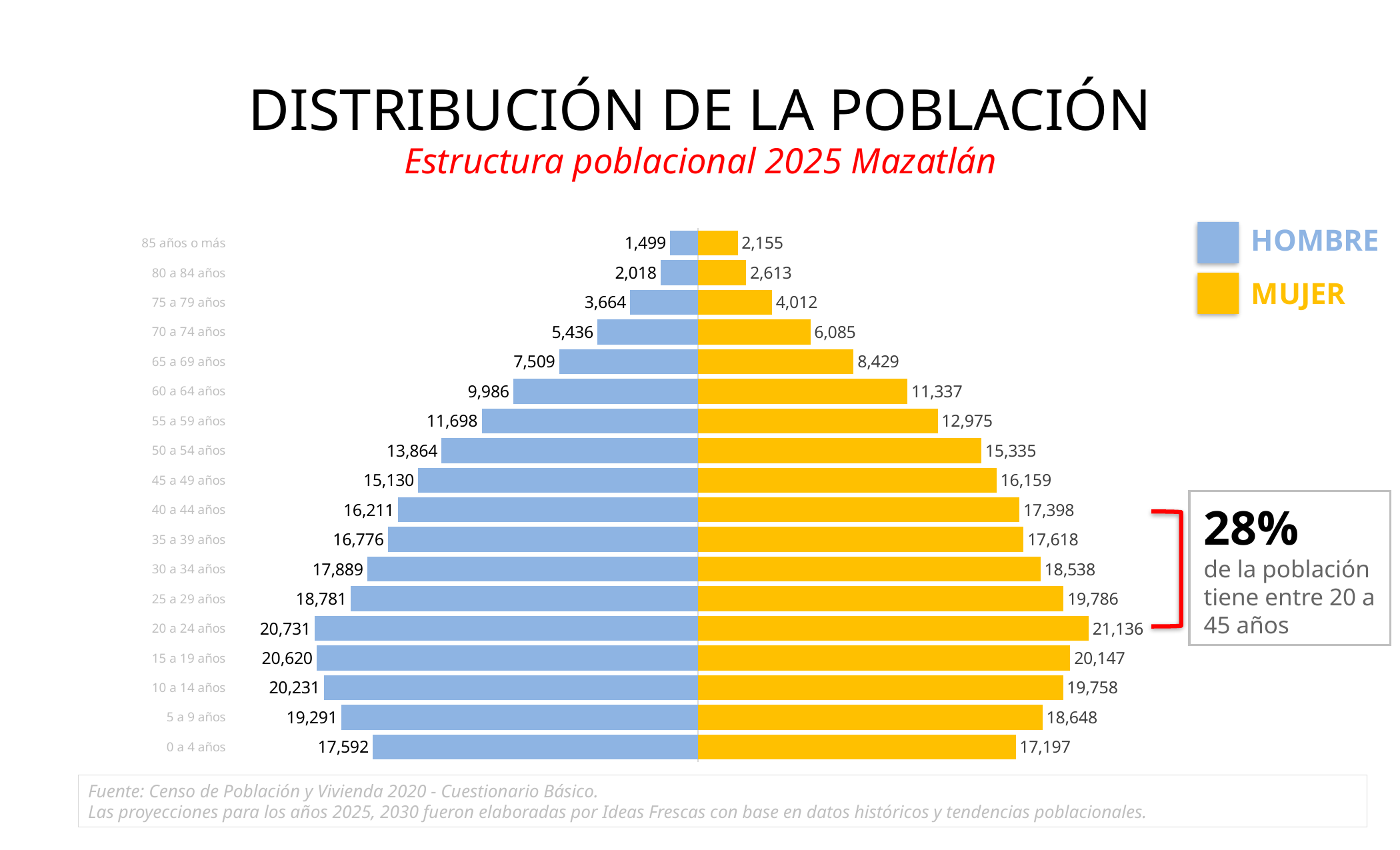
How many series does the legend list? 2 For the 15 a 19 años age group, which is larger, HOMBRE or MUJER? HOMBRE What is the difference between the MUJER and HOMBRE values for the 20 a 24 años age group? 405 What is the combined HOMBRE and MUJER value for the 0 a 4 años age group? 34,789 What is the HOMBRE value for the 20 a 24 años age group? 20,731 How many age groups are shown in the chart? 18 What colour represents the MUJER series in the chart? Yellow What is the MUJER value for the 60 a 64 años age group? 11,337 Which age group has the highest MUJER value? 20 a 24 años Which age group has the lowest HOMBRE value? 85 años o más What kind of chart is shown on the slide? Bar chart What is the MUJER value for the 0 a 4 años age group? 17,197